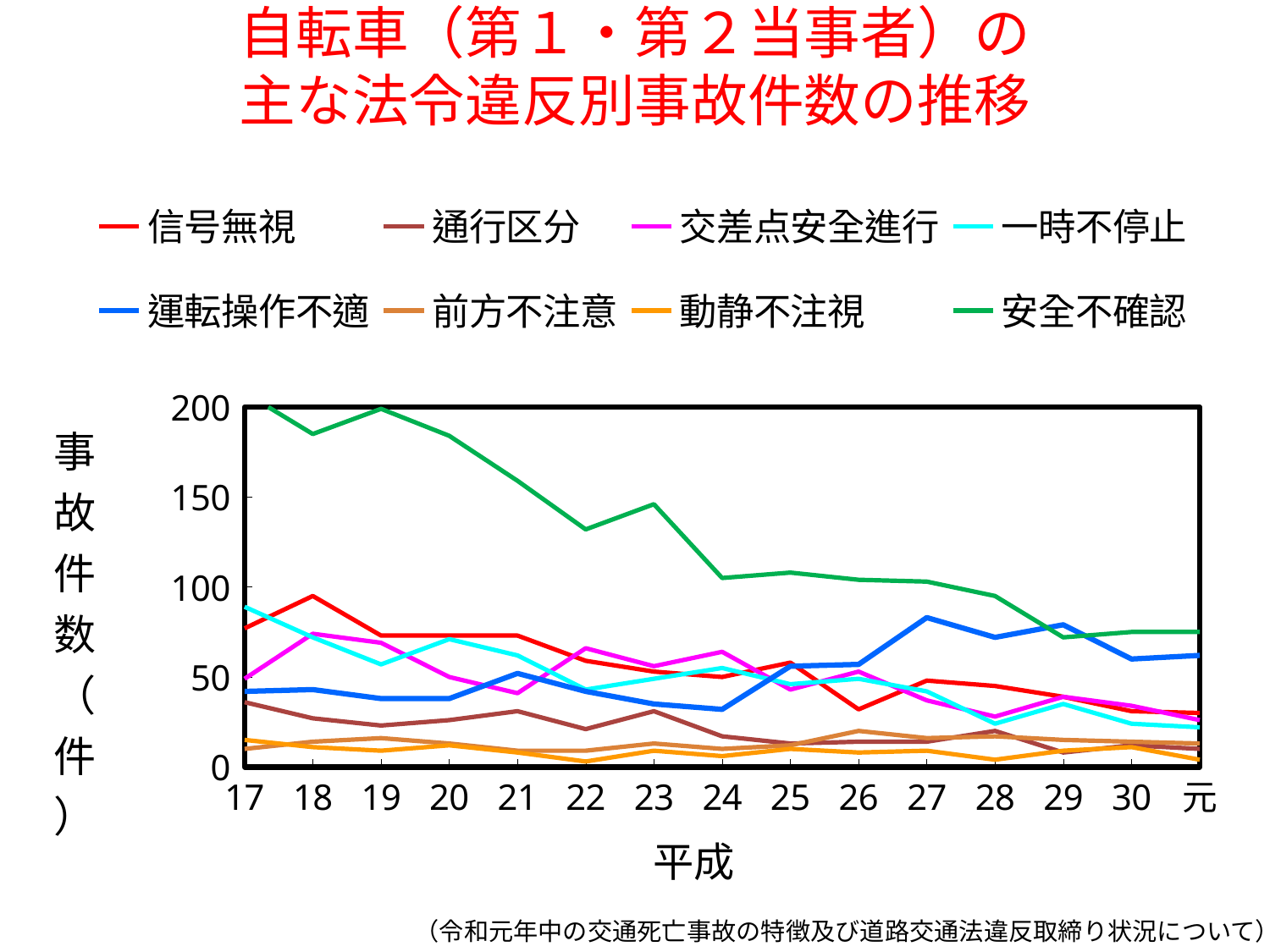
Does the value for 安全不確認 rise or fall from 平成17 to 元? fall Which series has the highest value at 平成17? 安全不確認 How many points are on the x axis of the chart? 15 How many series does the legend list? 8 Is the value for 運転操作不適 at 平成24 greater or less than 50? less Is the value for 安全不確認 at 平成17 greater or less than 150? greater At 平成27, which is larger: 運転操作不適 or 信号無視? 運転操作不適 What is the label on the x axis of the chart? 平成 Is the value for 信号無視 at 平成18 greater or less than 50? greater Which series has the highest value at 元? 安全不確認 What kind of chart is shown on the slide? line chart